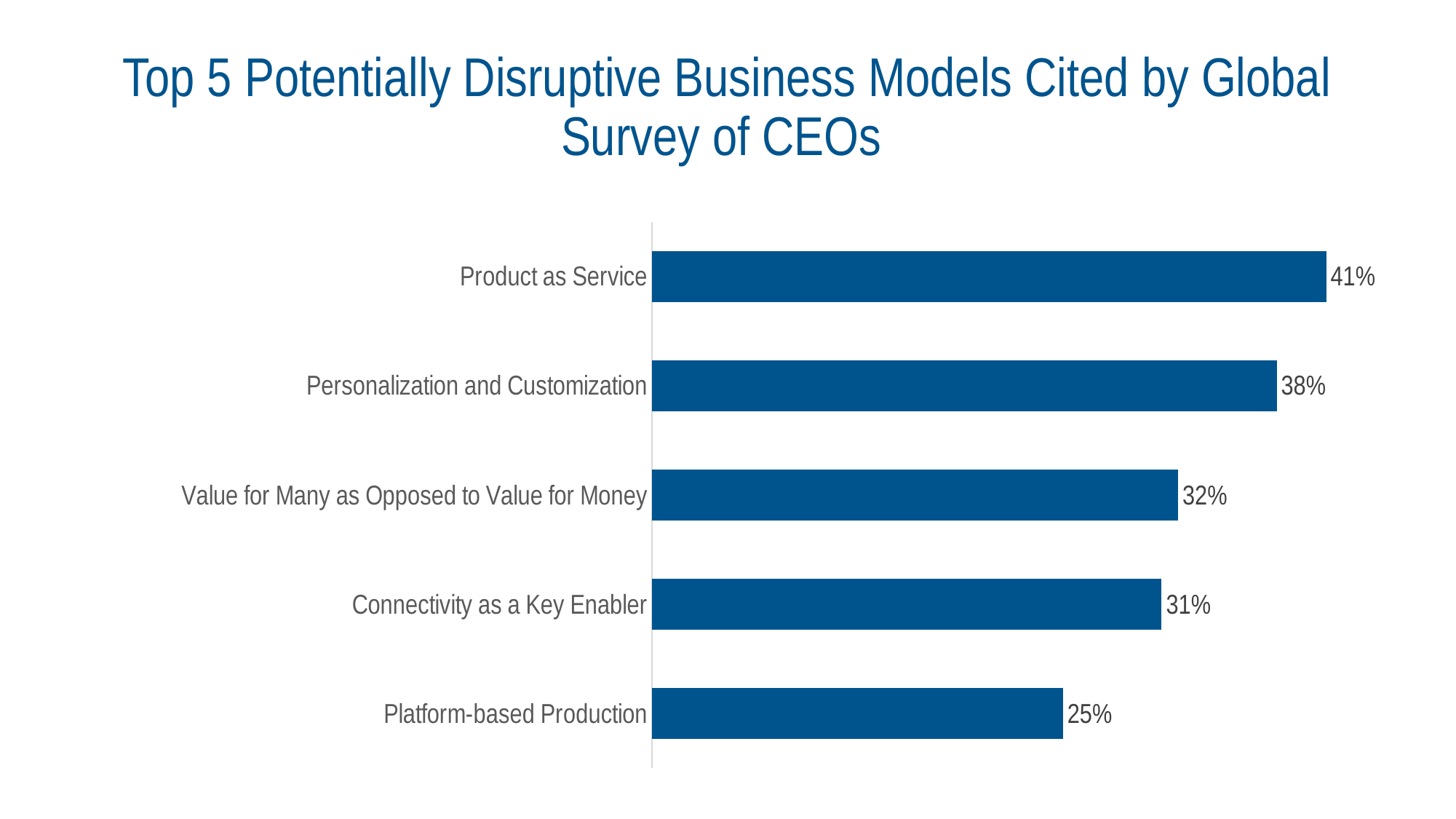
What is the title of the chart? Top 5 Potentially Disruptive Business Models Cited by Global Survey of CEOs What is the difference between the values for Product as Service and Platform-based Production? 16% Which business model has the lowest value? Platform-based Production What is the value for Platform-based Production? 25% What is the value for Connectivity as a Key Enabler? 31% What is the difference between Personalization and Customization and Value for Many as Opposed to Value for Money? 6% How many business models are shown in the chart? 5 Which is larger: the value for Personalization and Customization or the value for Connectivity as a Key Enabler? Personalization and Customization What percentage of CEOs cited Product as Service? 41% What kind of chart is shown on the slide? Bar chart Which business model has the highest value? Product as Service What is the value for Personalization and Customization? 38%